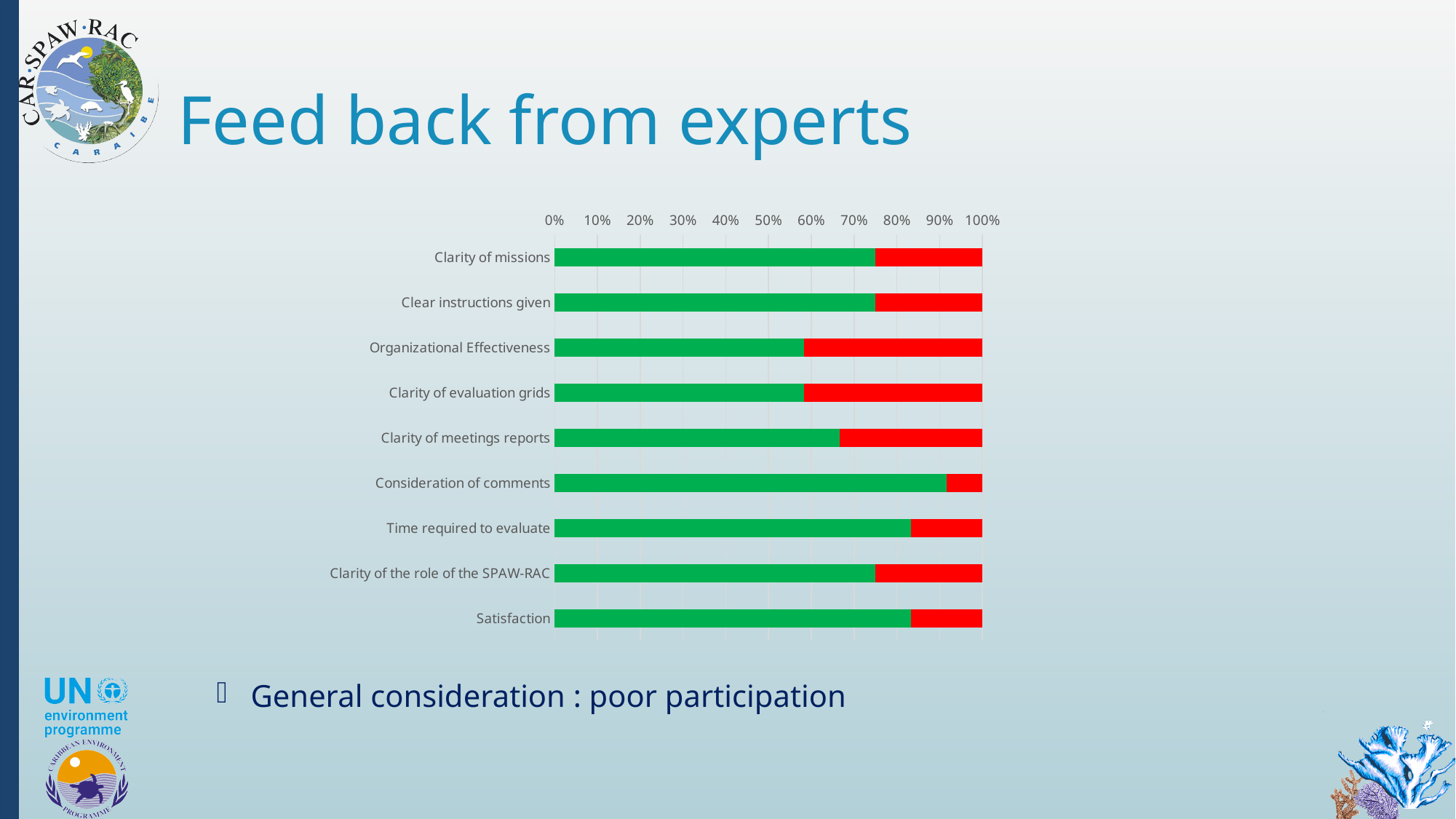
Is the green segment for Clarity of meetings reports greater or less than 70%? less Which has the larger red segment, Organizational Effectiveness or Consideration of comments? Organizational Effectiveness What kind of chart is shown on the slide? Stacked bar chart Is the green segment for Consideration of comments greater or less than 80%? greater Is the green segment for Organizational Effectiveness greater or less than 70%? less How many categories are plotted on the chart? 9 What is the highest value shown on the percentage axis? 100% Which has the larger green segment, Consideration of comments or Clarity of meetings reports? Consideration of comments What two colours are used for the bar segments? Green and red Which category has the largest green segment? Consideration of comments